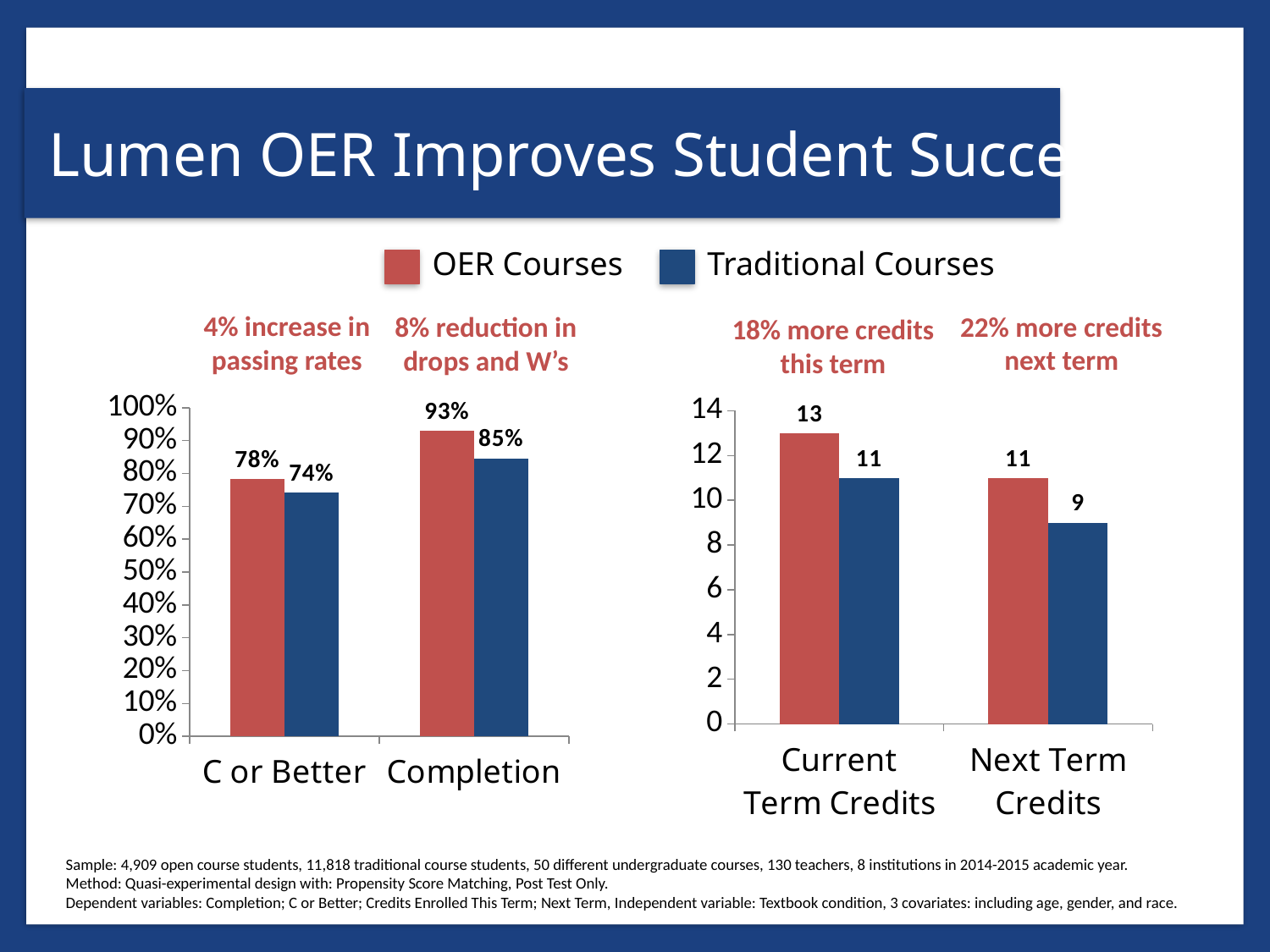
In the left chart, which series has the higher value for C or Better, OER Courses or Traditional Courses? OER Courses In the left chart, what is the value for Traditional Courses in the Completion category? 85% In the left chart, what is the value for OER Courses in the C or Better category? 78% In the right chart, which category has the lowest value for Traditional Courses? Next Term Credits In the right chart, what is the difference between OER Courses and Traditional Courses for Next Term Credits? 2 How many categories are shown on the x axis of the right chart? 2 In the left chart, what is the difference between OER Courses and Traditional Courses for Completion? 8% In the right chart, what is the value for OER Courses in Current Term Credits? 13 In the left chart, which category has the highest value for OER Courses? Completion How many series does the legend list? 2 In the right chart, what is the value for Traditional Courses in Next Term Credits? 9 What kind of chart is the left chart? Bar chart